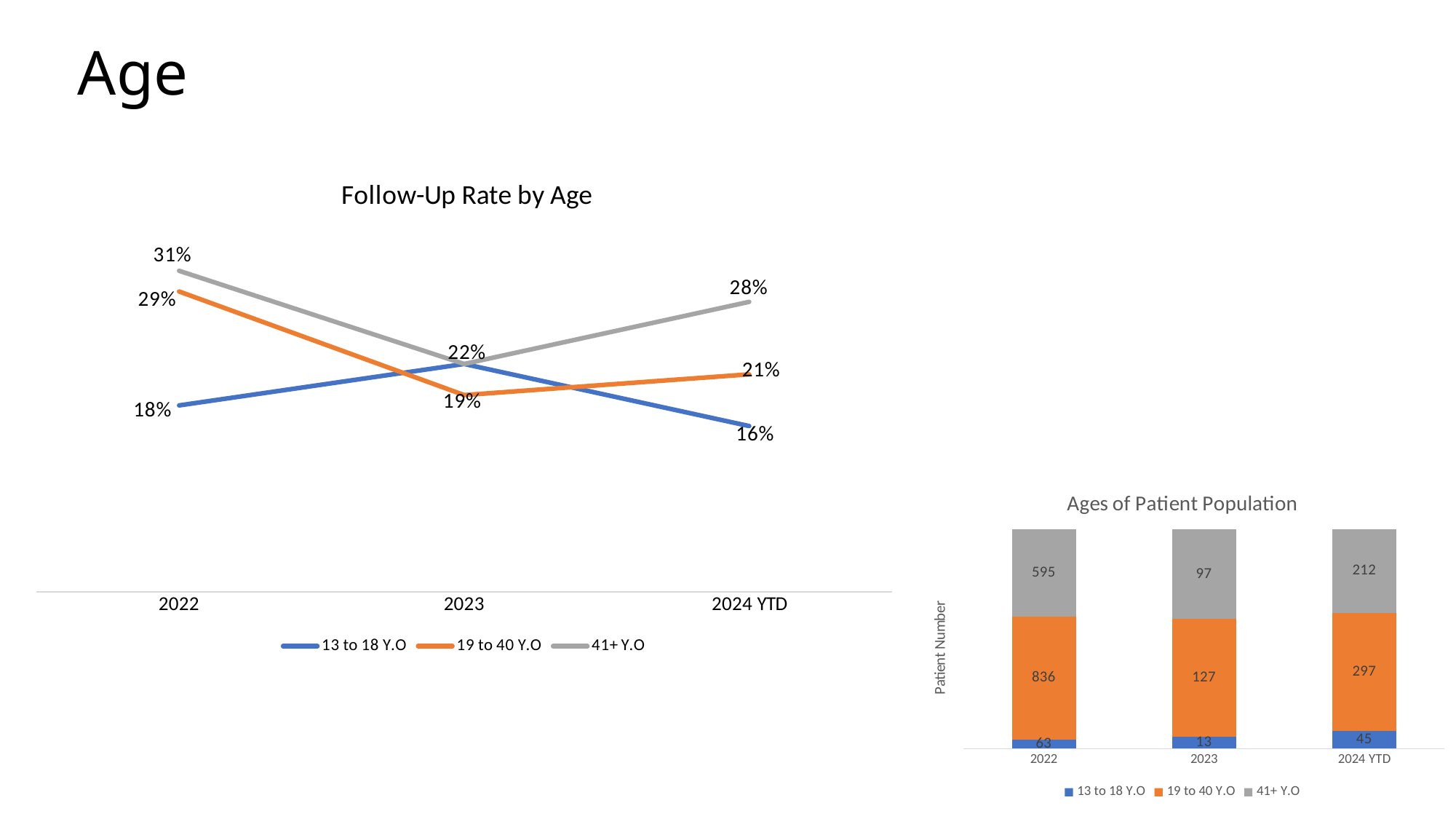
In the Follow-Up Rate by Age chart, what is the follow-up rate for 13 to 18 Y.O in 2024 YTD? 16% In the Follow-Up Rate by Age chart, does the 13 to 18 Y.O follow-up rate rise or fall from 2023 to 2024 YTD? fall In the Follow-Up Rate by Age chart, how many series does the legend list? 3 In the Ages of Patient Population chart, which is larger in 2024 YTD: 41+ Y.O or 13 to 18 Y.O? 41+ Y.O In the Ages of Patient Population chart, how many 19 to 40 Y.O patients were there in 2022? 836 In the Ages of Patient Population chart, what is the total number of patients in the 2023 bar? 237 In the Follow-Up Rate by Age chart, which age group has the highest follow-up rate in 2024 YTD? 41+ Y.O In the Follow-Up Rate by Age chart, what is the follow-up rate for 41+ Y.O in 2022? 31% In the Follow-Up Rate by Age chart, what is the difference between the 41+ Y.O and 13 to 18 Y.O follow-up rates in 2022? 13% In the Follow-Up Rate by Age chart, which age group has the lowest follow-up rate in 2023? 19 to 40 Y.O In the Ages of Patient Population chart, how many bars (years) are shown on the x axis? 3 What kind of chart is the Follow-Up Rate by Age chart? line chart